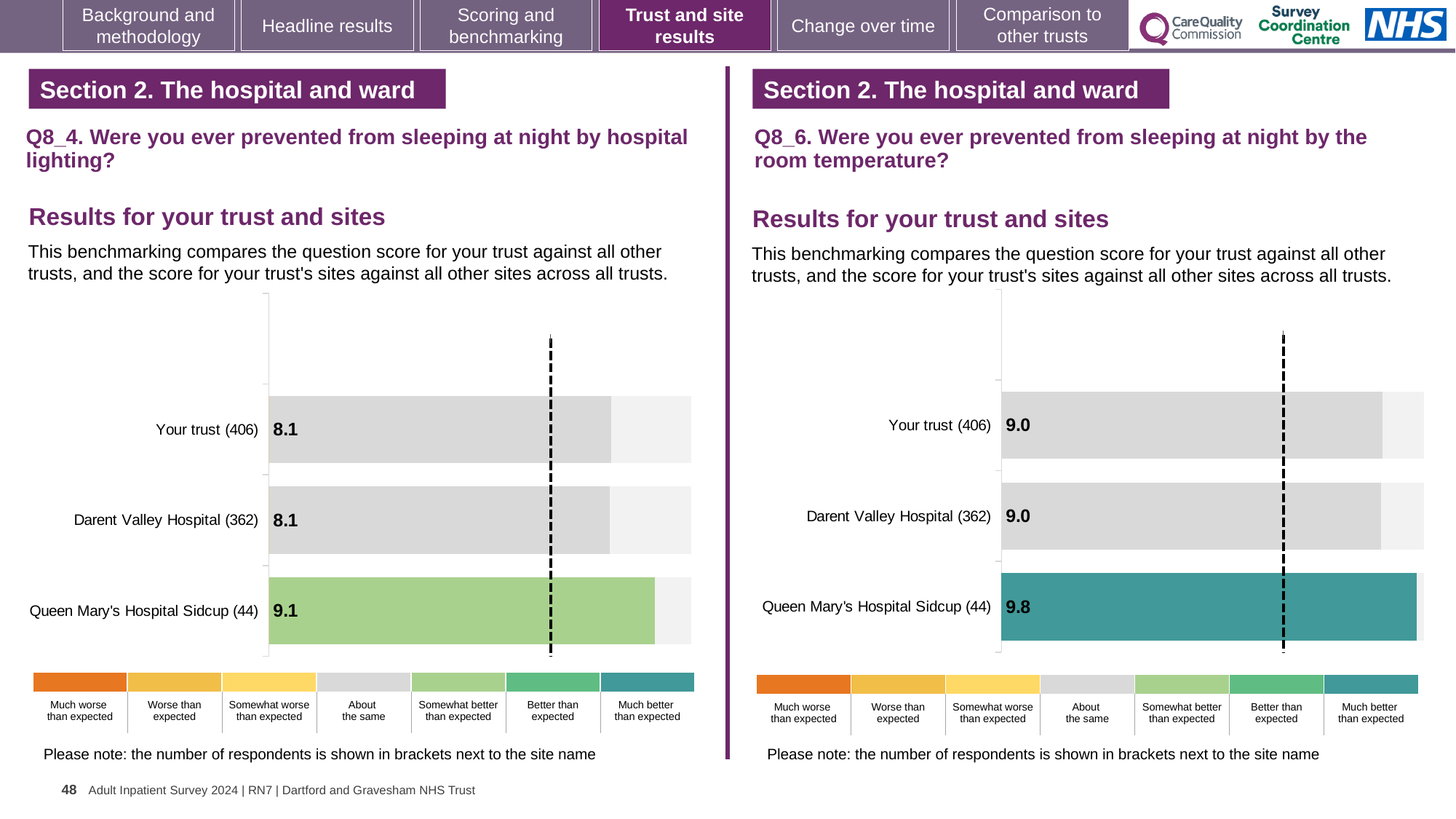
In the Q8_4 chart on the left (hospital lighting), what is the difference between the scores for Queen Mary's Hospital Sidcup and Darent Valley Hospital? 1.0 In the Q8_6 chart on the right (room temperature), what is the score for Darent Valley Hospital? 9.0 In the Q8_4 chart on the left (hospital lighting), which site or trust has the highest score? Queen Mary's Hospital Sidcup In the Q8_6 chart on the right (room temperature), which has the larger score: Queen Mary's Hospital Sidcup or Darent Valley Hospital? Queen Mary's Hospital Sidcup In the Q8_6 chart on the right (room temperature), what is the score for Queen Mary's Hospital Sidcup? 9.8 In the Q8_4 chart on the left (hospital lighting), what is the score for Queen Mary's Hospital Sidcup? 9.1 In the Q8_6 chart on the right (room temperature), which site or trust has the highest score? Queen Mary's Hospital Sidcup In the Q8_4 chart on the left (hospital lighting), what is the score for Your trust? 8.1 In the Q8_6 chart on the right (room temperature), what is the difference between the scores for Queen Mary's Hospital Sidcup and Your trust? 0.8 How many bars are plotted in the Q8_4 chart on the left (hospital lighting)? 3 In the Q8_6 chart on the right (room temperature), how many respondents are shown in brackets for Queen Mary's Hospital Sidcup? 44 What kind of chart is used in the Q8_6 chart on the right (room temperature)? Bar chart